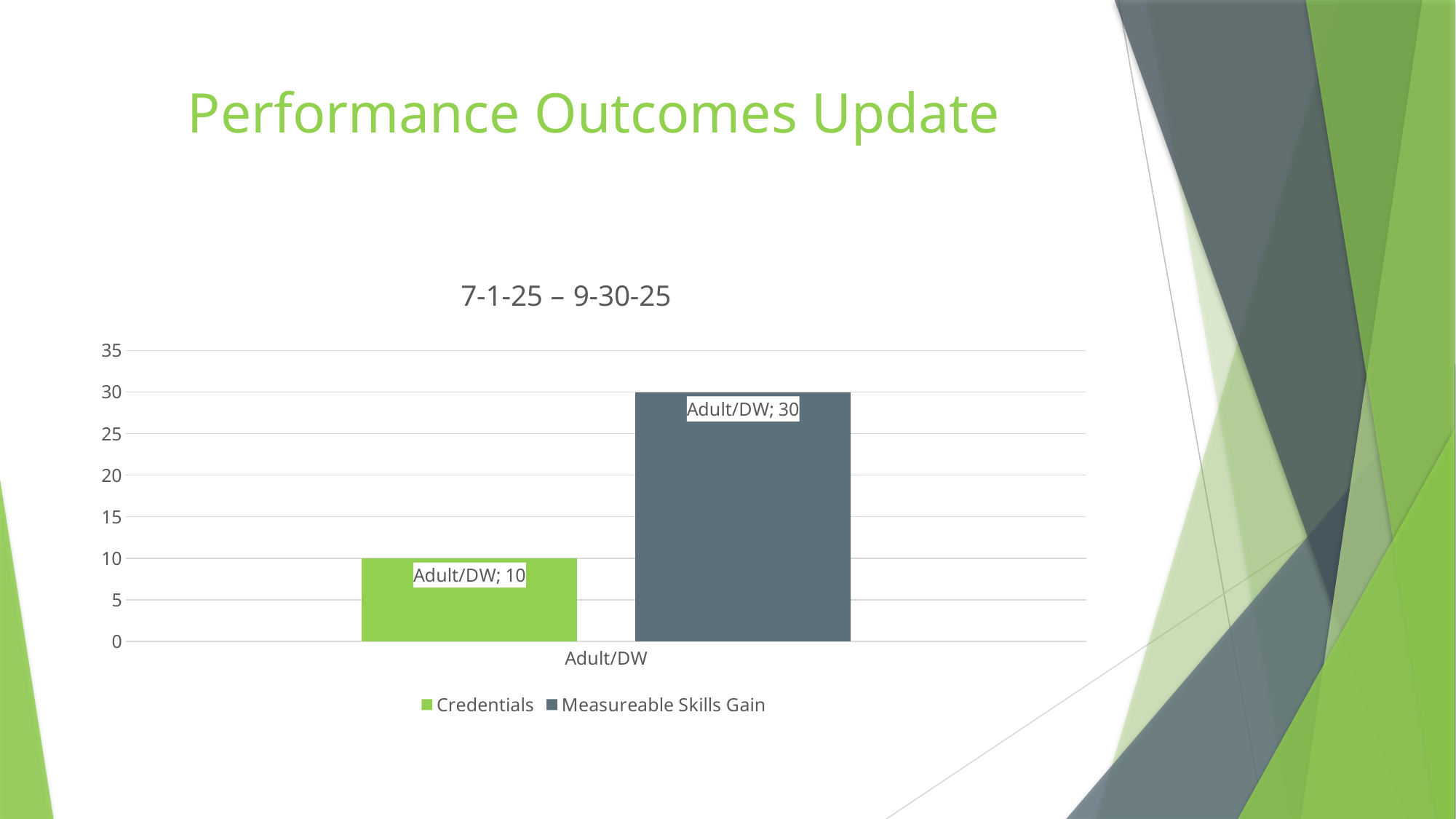
Which series has the higher value for Adult/DW, Credentials or Measureable Skills Gain? Measureable Skills Gain How many categories are shown on the x axis? 1 What is the title of the chart? 7-1-25 – 9-30-25 Is the value for Measureable Skills Gain greater or less than 25? greater What kind of chart is shown on the slide? bar chart What is the difference between the Measureable Skills Gain value and the Credentials value for Adult/DW? 20 Is the value for Credentials greater or less than 15? less What is the value for Credentials for Adult/DW? 10 Which series has the lowest value on the chart? Credentials What colour is the Credentials bar? green How many series does the legend list? 2 What is the value for Measureable Skills Gain for Adult/DW? 30